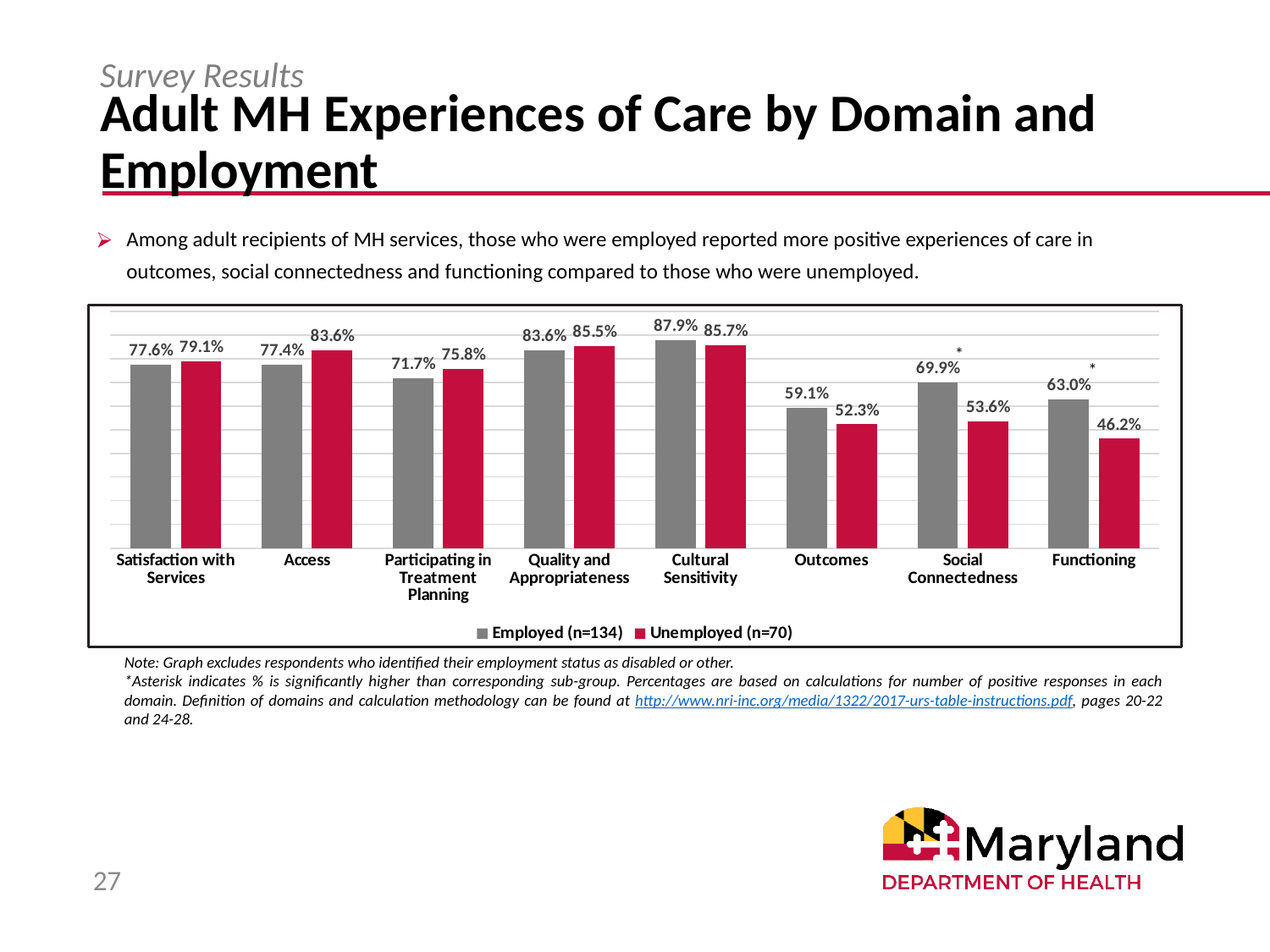
How many domains are shown on the x axis of the chart? 8 Which domain has the lowest value for Unemployed (n=70)? Functioning What is the value for Employed (n=134) in the Outcomes domain? 59.1% What is the difference between the Employed (n=134) and Unemployed (n=70) values for Social Connectedness? 16.3% What colour are the bars for Unemployed (n=70)? Red Which is larger in the Quality and Appropriateness domain: Employed (n=134) or Unemployed (n=70)? Unemployed (n=70) How many series does the legend list? 2 What kind of chart is shown on the slide? Bar chart What is the value for Unemployed (n=70) in the Functioning domain? 46.2% Which domain has the highest value for Employed (n=134)? Cultural Sensitivity What is the value for Unemployed (n=70) in the Access domain? 83.6% Which is larger in the Functioning domain: Employed (n=134) or Unemployed (n=70)? Employed (n=134)